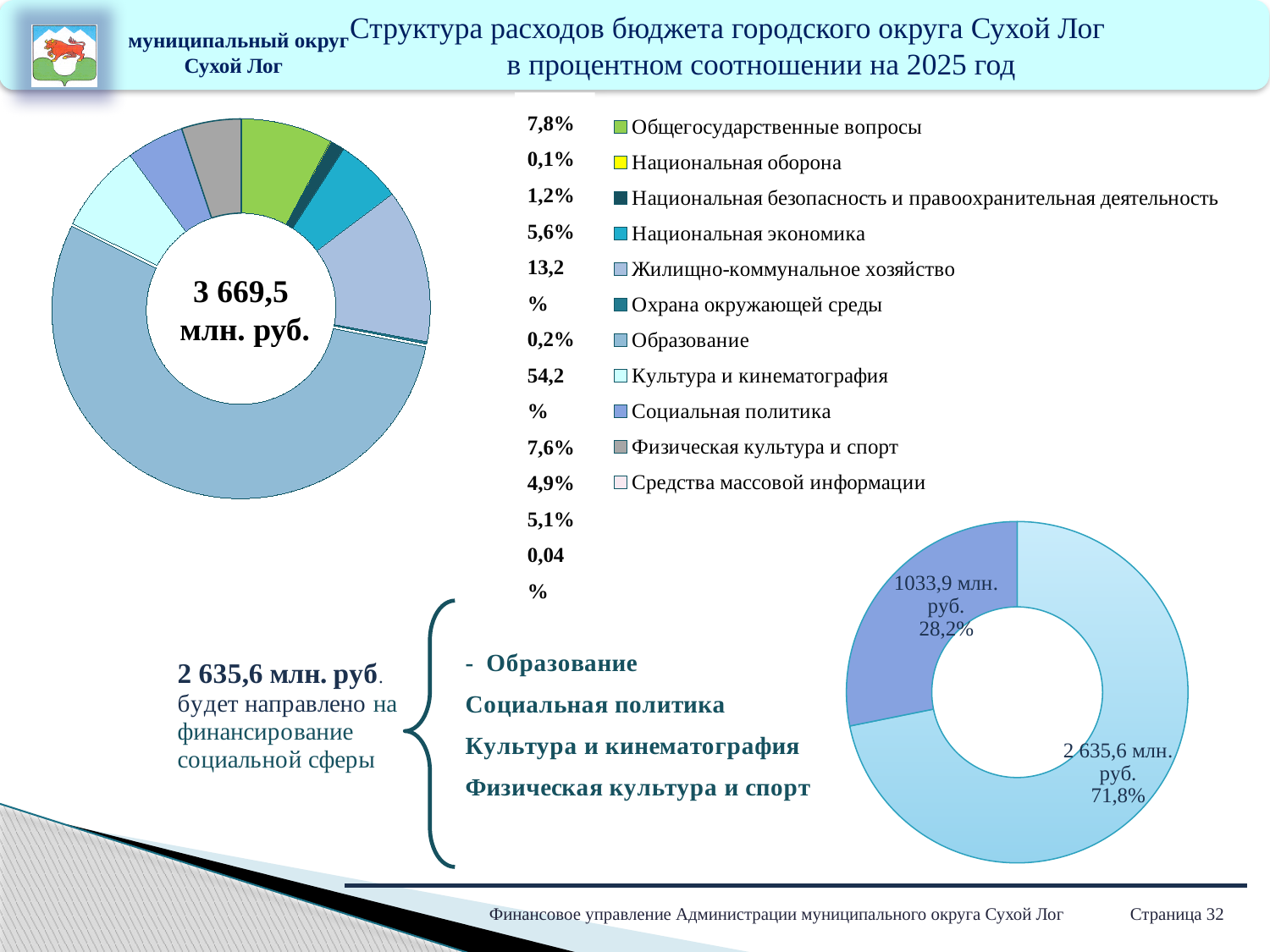
In the chart at the bottom right, what percentage share does the smaller slice have? 28,2% In the chart at the bottom right, what is the difference in percentage points between the two slices (71,8% and 28,2%)? 43,6 In the left chart, which category has the smallest share? Средства массовой информации In the chart at the bottom right, what value is printed on the larger slice? 2 635,6 млн. руб. In the left chart, which category has the largest share? Образование In the left chart, what share is shown for Общегосударственные вопросы? 7,8% How many categories does the legend of the left chart list? 11 In the left chart, what total value is printed in the centre of the ring? 3 669,5 млн. руб. In the left chart, what share is shown for Национальная экономика? 5,6% In the left chart, which is larger: Национальная экономика or Жилищно-коммунальное хозяйство? Жилищно-коммунальное хозяйство In the left chart, what share is shown for Национальная оборона? 0,1% What kind of chart is the chart on the left of the slide? doughnut chart